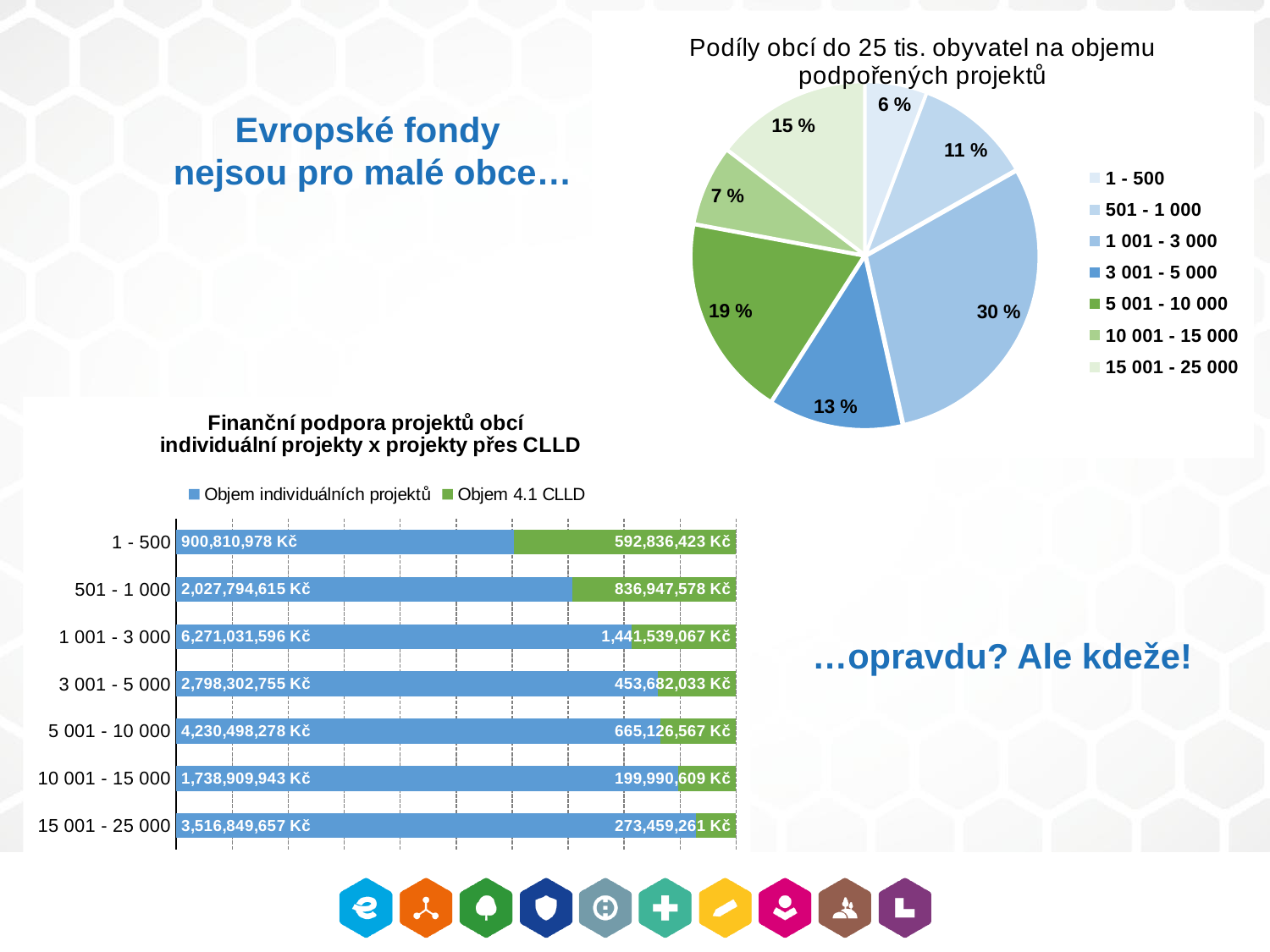
In the bar chart 'Finanční podpora projektů obcí', which category has the highest Objem individuálních projektů value? 1 001 - 3 000 In the bar chart 'Finanční podpora projektů obcí', which category has the lowest Objem 4.1 CLLD value? 10 001 - 15 000 In the pie chart 'Podíly obcí do 25 tis. obyvatel na objemu podpořených projektů', what share is shown for the 1 001 - 3 000 category? 30 % What type of chart is the chart at the bottom left of the slide, 'Finanční podpora projektů obcí'? Stacked bar chart In the pie chart 'Podíly obcí do 25 tis. obyvatel na objemu podpořených projektů', what is the difference in percentage points between the 5 001 - 10 000 share and the 10 001 - 15 000 share? 12 percentage points In the bar chart 'Finanční podpora projektů obcí', what is the value of Objem 4.1 CLLD for the 1 - 500 category? 592,836,423 Kč In the bar chart 'Finanční podpora projektů obcí', what is the value of Objem individuálních projektů for the 1 001 - 3 000 category? 6,271,031,596 Kč In the pie chart 'Podíly obcí do 25 tis. obyvatel na objemu podpořených projektů', which category has the largest share? 1 001 - 3 000 In the pie chart 'Podíly obcí do 25 tis. obyvatel na objemu podpořených projektů', how many categories does the legend list? 7 In the pie chart 'Podíly obcí do 25 tis. obyvatel na objemu podpořených projektů', which category has the smallest share? 1 - 500 In the bar chart 'Finanční podpora projektů obcí', how many series does the legend list? 2 In the bar chart 'Finanční podpora projektů obcí', which is larger: Objem 4.1 CLLD for 501 - 1 000 or Objem 4.1 CLLD for 3 001 - 5 000? 501 - 1 000